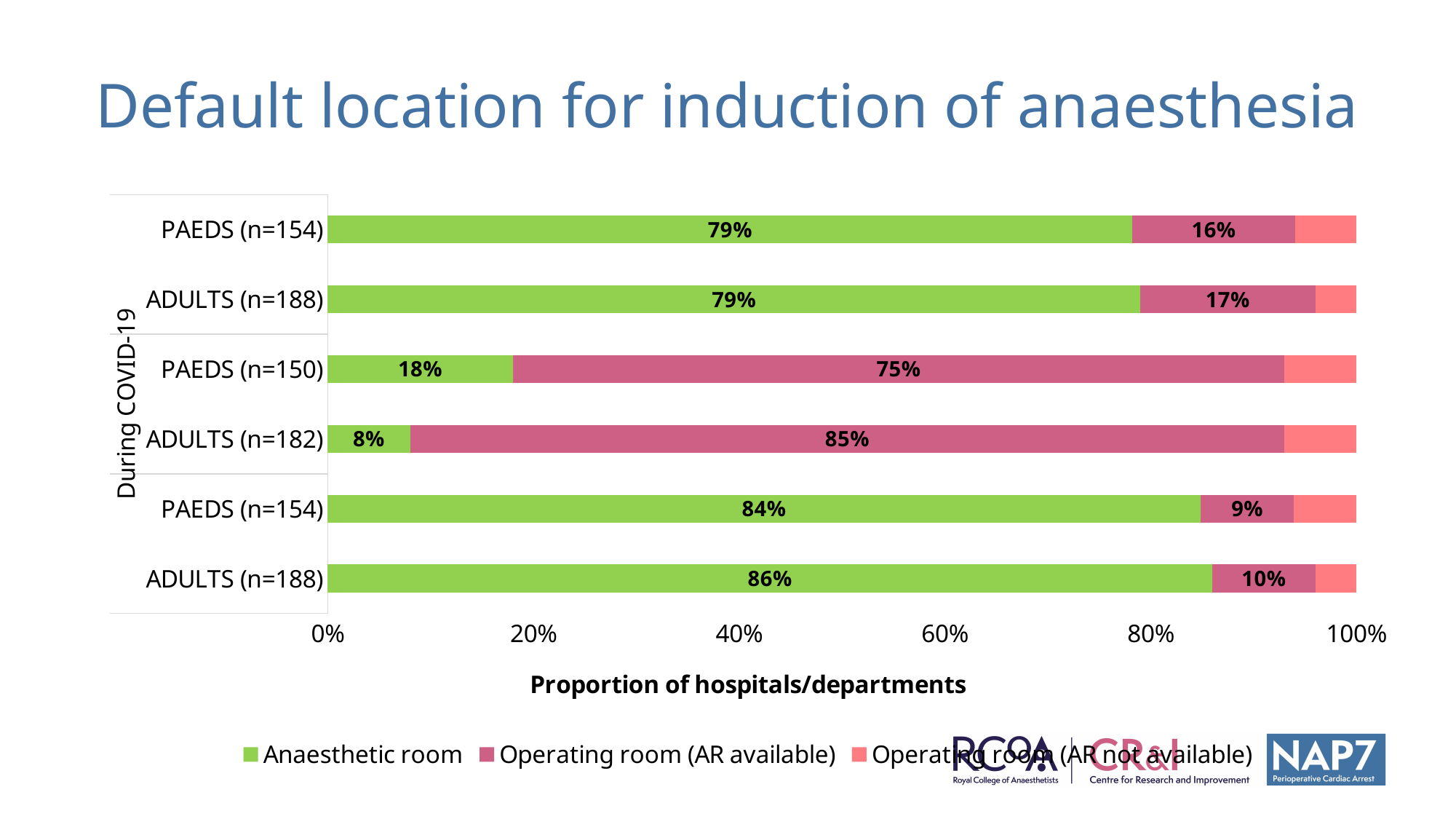
Which bar has the lowest Anaesthetic room value? During COVID-19 ADULTS (n=182) In the During COVID-19 group, which has the larger Anaesthetic room value, PAEDS (n=150) or ADULTS (n=182)? PAEDS (n=150) What is the title of the horizontal axis? Proportion of hospitals/departments How many series does the legend list? 3 In the During COVID-19 group, what is the difference between the Operating room (AR available) values for ADULTS (n=182) and PAEDS (n=150)? 10 percentage points How many bars are plotted in the chart? 6 What kind of chart is shown on the slide? bar chart In the During COVID-19 group, what is the Anaesthetic room value for ADULTS (n=182)? 8% What is the Operating room (AR available) value for the topmost bar, PAEDS (n=154)? 16% In the During COVID-19 group, what is the Operating room (AR available) value for PAEDS (n=150)? 75% Which bar has the highest Anaesthetic room value? The bottom bar, ADULTS (n=188) What is the Anaesthetic room value for the bottom bar, ADULTS (n=188)? 86%